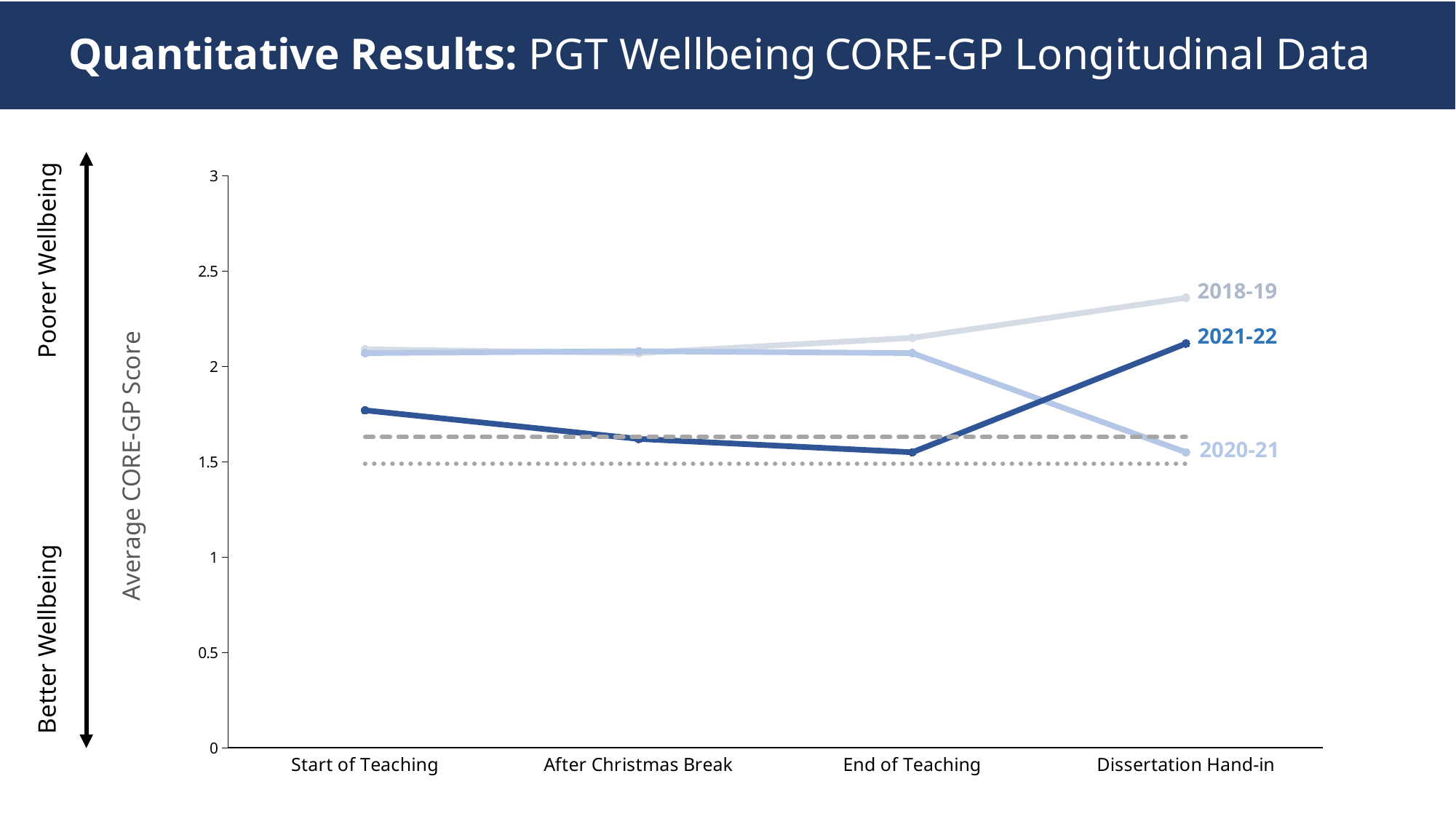
Is the 2021-22 score at End of Teaching greater or less than 2? less At Start of Teaching, which is higher: the 2018-19 score or the 2021-22 score? 2018-19 Which cohort has the highest score at Dissertation Hand-in? 2018-19 What is the label of the y axis? Average CORE-GP Score Which cohort has the lowest score at Dissertation Hand-in? 2020-21 Which cohort has the lowest score at End of Teaching? 2021-22 Is the 2021-22 score at Start of Teaching greater or less than 1.5? greater Is the 2018-19 score at Dissertation Hand-in greater or less than 2? greater Does the 2018-19 score rise or fall from Start of Teaching to Dissertation Hand-in? rise How many time points are shown along the x axis? 4 How many cohort series are plotted on the chart? 3 What kind of chart is shown on the slide? line chart